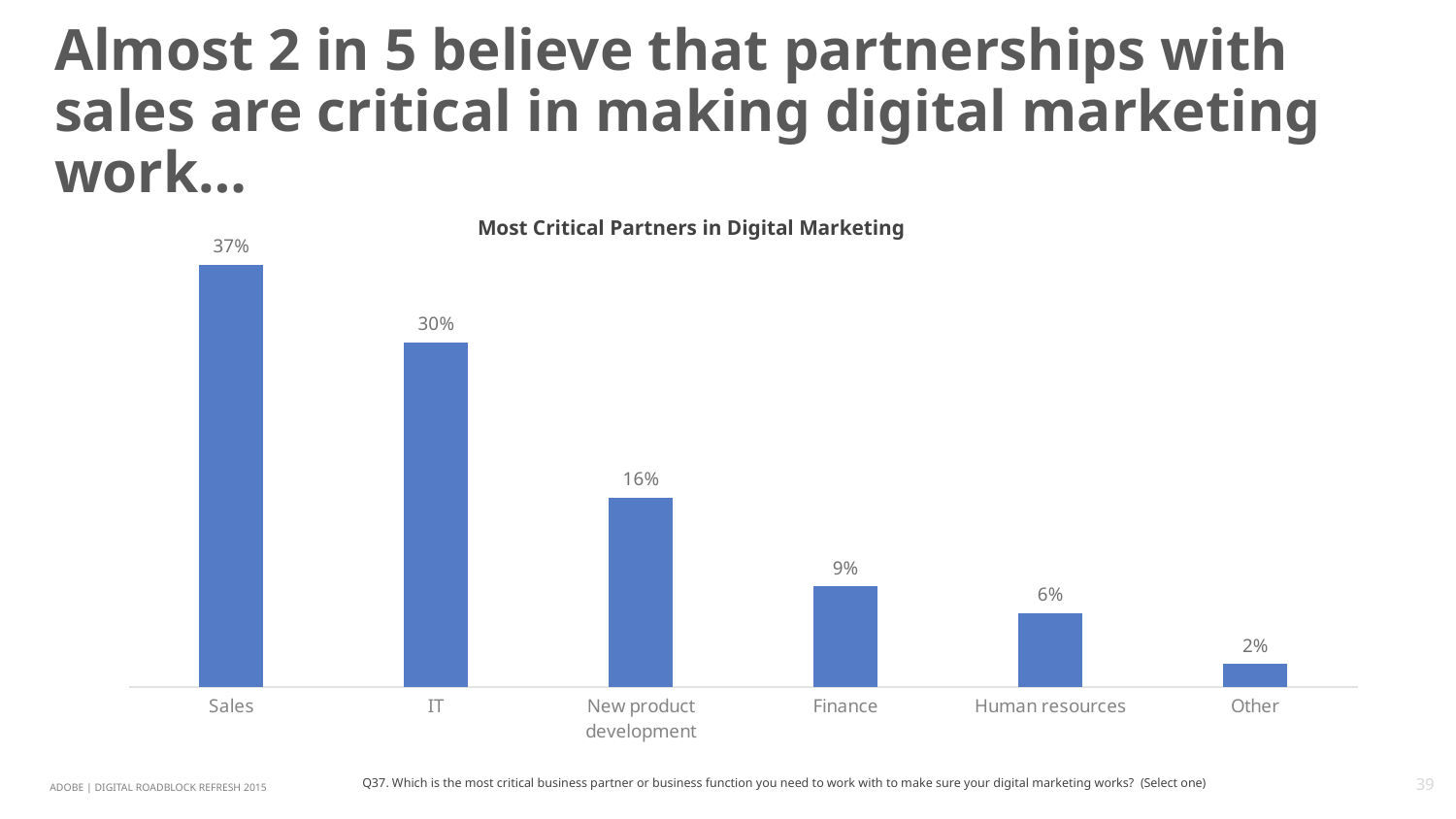
Which category has the lowest value? Other What is the value for New product development? 16% Which category has the highest value? Sales What is the difference between the values for Sales and IT? 7% What is the difference between the values for Finance and Other? 7% What is the value for IT? 30% What is the title of the chart? Most Critical Partners in Digital Marketing Which is larger, the value for Finance or the value for Human resources? Finance What is the value for Sales? 37% What kind of chart is shown on the slide? Bar chart How many categories are shown in the chart? 6 What is the value for Human resources? 6%